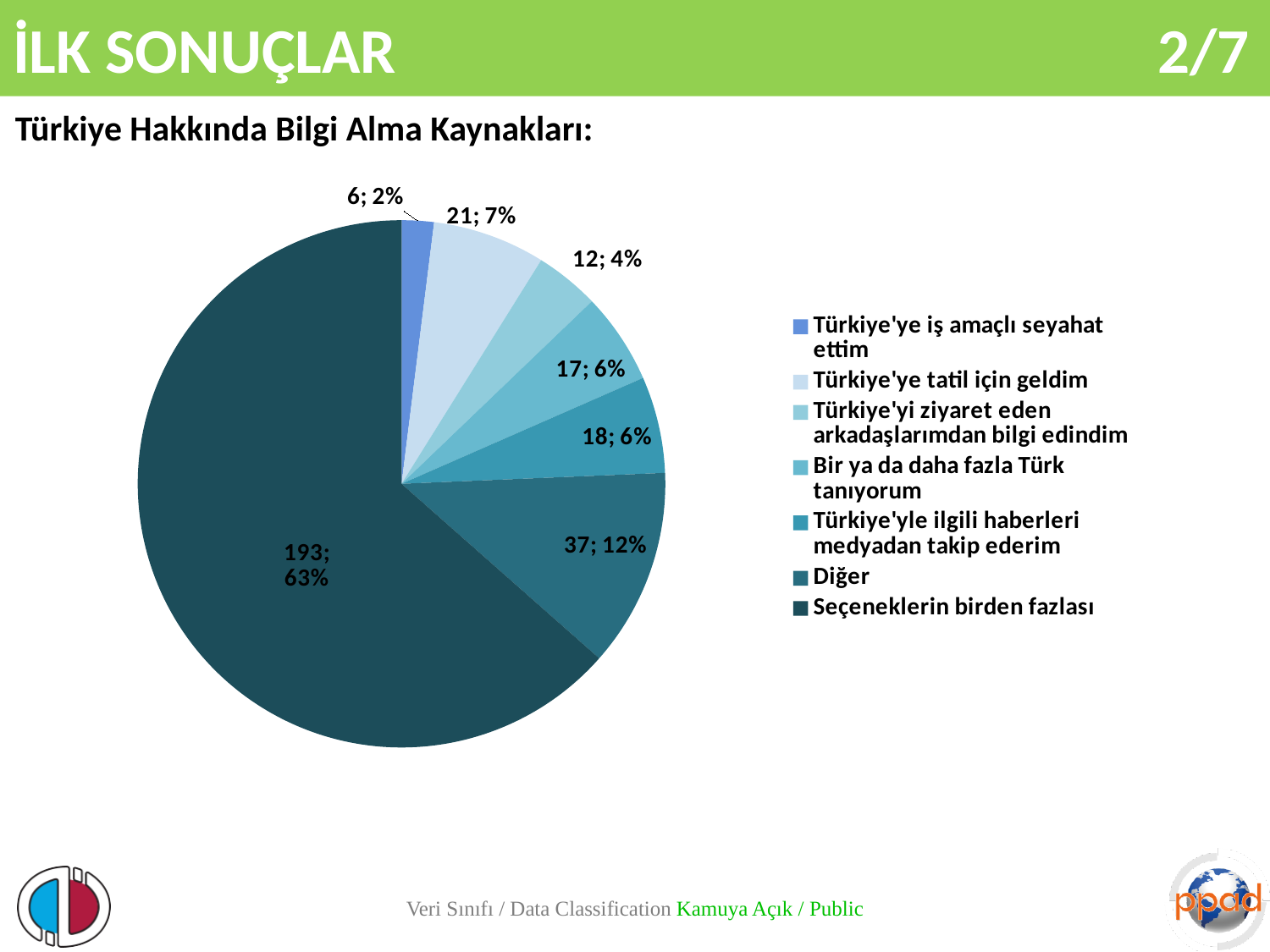
What kind of chart is shown on the slide? Pie chart What is the count shown for 'Türkiye'yi ziyaret eden arkadaşlarımdan bilgi edindim'? 12 Which category has the smallest slice in the pie chart? Türkiye'ye iş amaçlı seyahat ettim What is the heading above the pie chart? Türkiye Hakkında Bilgi Alma Kaynakları: What percentage share does 'Türkiye'ye tatil için geldim' have? 7% What percentage share does 'Seçeneklerin birden fazlası' have in the pie chart? 63% What is the count shown for 'Seçeneklerin birden fazlası'? 193 Which has a larger count: 'Bir ya da daha fazla Türk tanıyorum' or 'Türkiye'ye iş amaçlı seyahat ettim'? Bir ya da daha fazla Türk tanıyorum Which category has the largest slice in the pie chart? Seçeneklerin birden fazlası What is the difference in count between 'Diğer' and 'Türkiye'ye tatil için geldim'? 16 How many slices does the pie chart have? 7 What is the count shown for 'Diğer'? 37